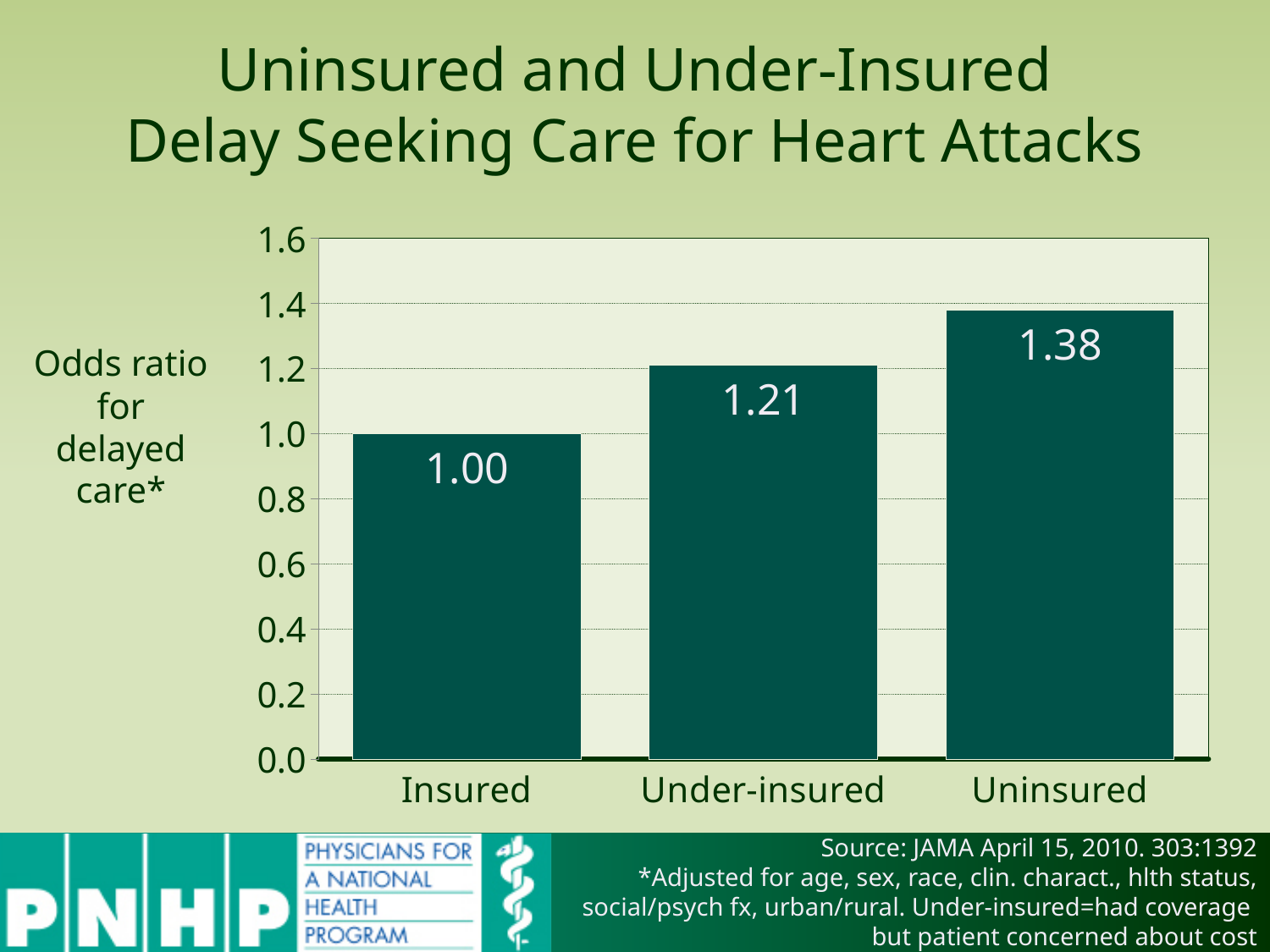
Which group has the lowest odds ratio for delayed care? Insured Do the odds ratios rise or fall moving from Insured to Uninsured along the x axis? Rise Which group has the highest odds ratio for delayed care? Uninsured Which group has a larger odds ratio for delayed care, Under-insured or Insured? Under-insured What kind of chart is shown on the slide? Bar chart What is the odds ratio for delayed care for the Uninsured group? 1.38 What is the odds ratio for delayed care for the Insured group? 1.00 What is the odds ratio for delayed care for the Under-insured group? 1.21 What is the difference between the odds ratios for the Uninsured and Under-insured groups? 0.17 What is the difference between the odds ratios for the Uninsured and Insured groups? 0.38 Is the odds ratio for the Uninsured group greater or less than 1.2? greater How many groups are shown on the chart? 3